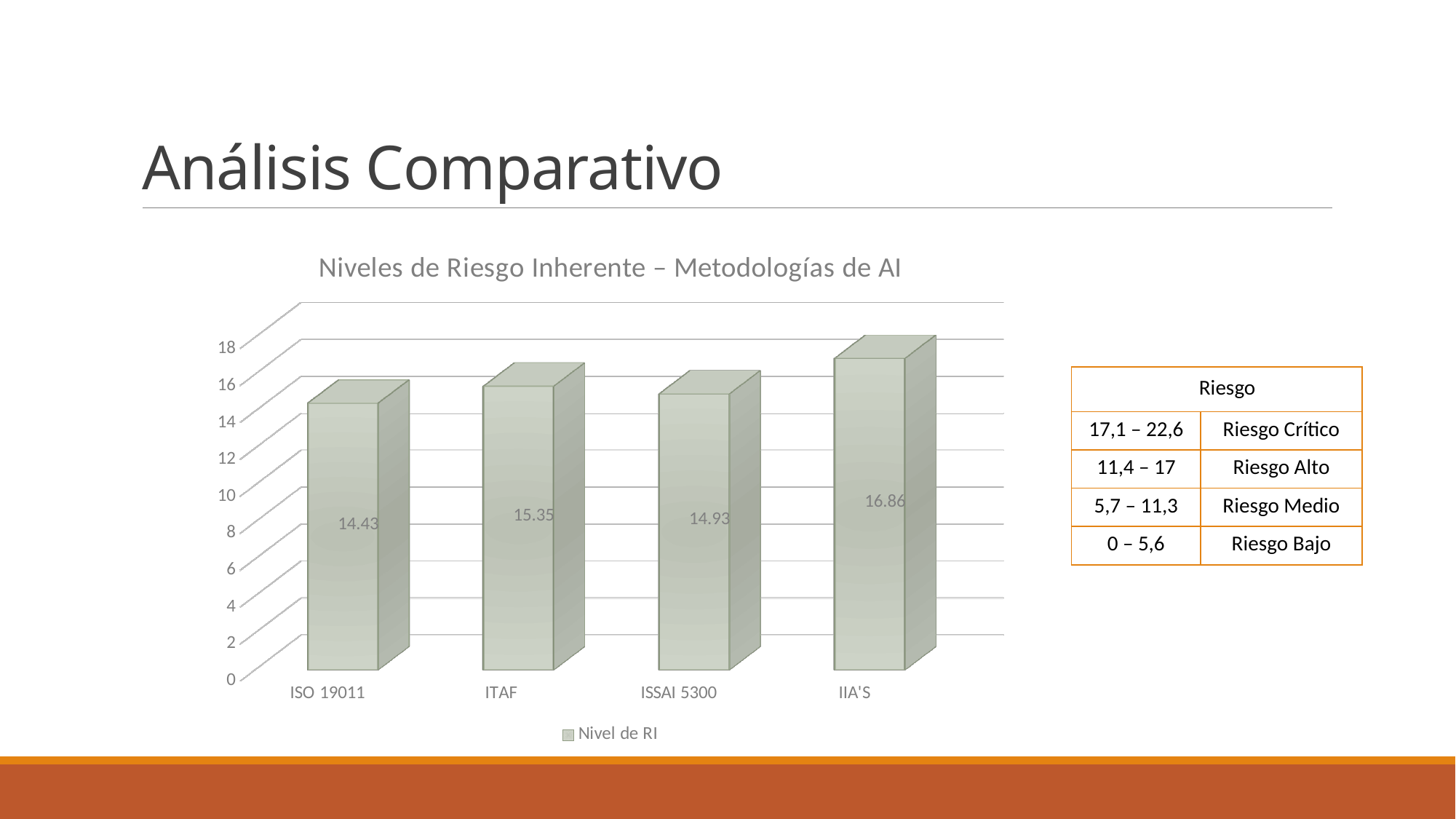
How many categories are shown on the x axis? 4 What is the value for IIA'S? 16.86 What is the title of the chart? Niveles de Riesgo Inherente – Metodologías de AI Is the value for IIA'S greater or less than 16? greater What is the value for ITAF? 15.35 What is the difference between the values for IIA'S and ISO 19011? 2.43 What is the value for ISSAI 5300? 14.93 Which category has the highest value? IIA'S What kind of chart is shown? bar chart What is the value for ISO 19011? 14.43 Which category has the lowest value? ISO 19011 Which is larger, the value for ITAF or the value for ISSAI 5300? ITAF